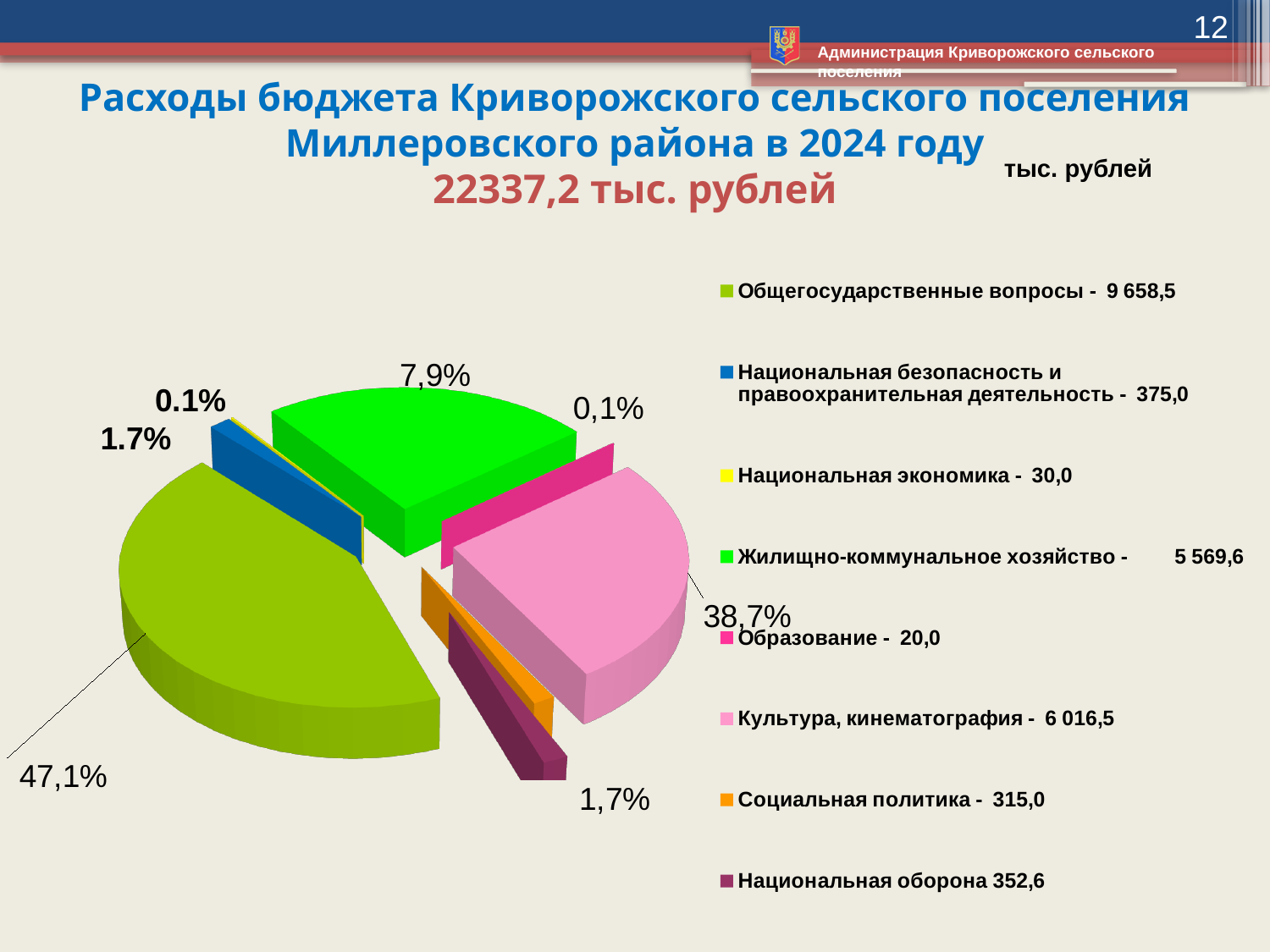
What colour represents Социальная политика in the chart? orange How many categories does the legend list? 8 According to the legend, what is the value for Национальная оборона? 352,6 According to the legend, what is the value for Культура, кинематография? 6 016,5 Which is larger: the value for Культура, кинематография or the value for Жилищно-коммунальное хозяйство? Культура, кинематография Which category has the largest value in the legend? Общегосударственные вопросы According to the legend, what is the value for Жилищно-коммунальное хозяйство? 5 569,6 What kind of chart is shown on the slide? pie chart According to the legend, what is the value for Общегосударственные вопросы? 9 658,5 What is the difference between the values for Общегосударственные вопросы and Культура, кинематография? 3 642,0 What is the difference between the values for Национальная безопасность и правоохранительная деятельность and Социальная политика? 60,0 Which category has the smallest value in the legend? Образование